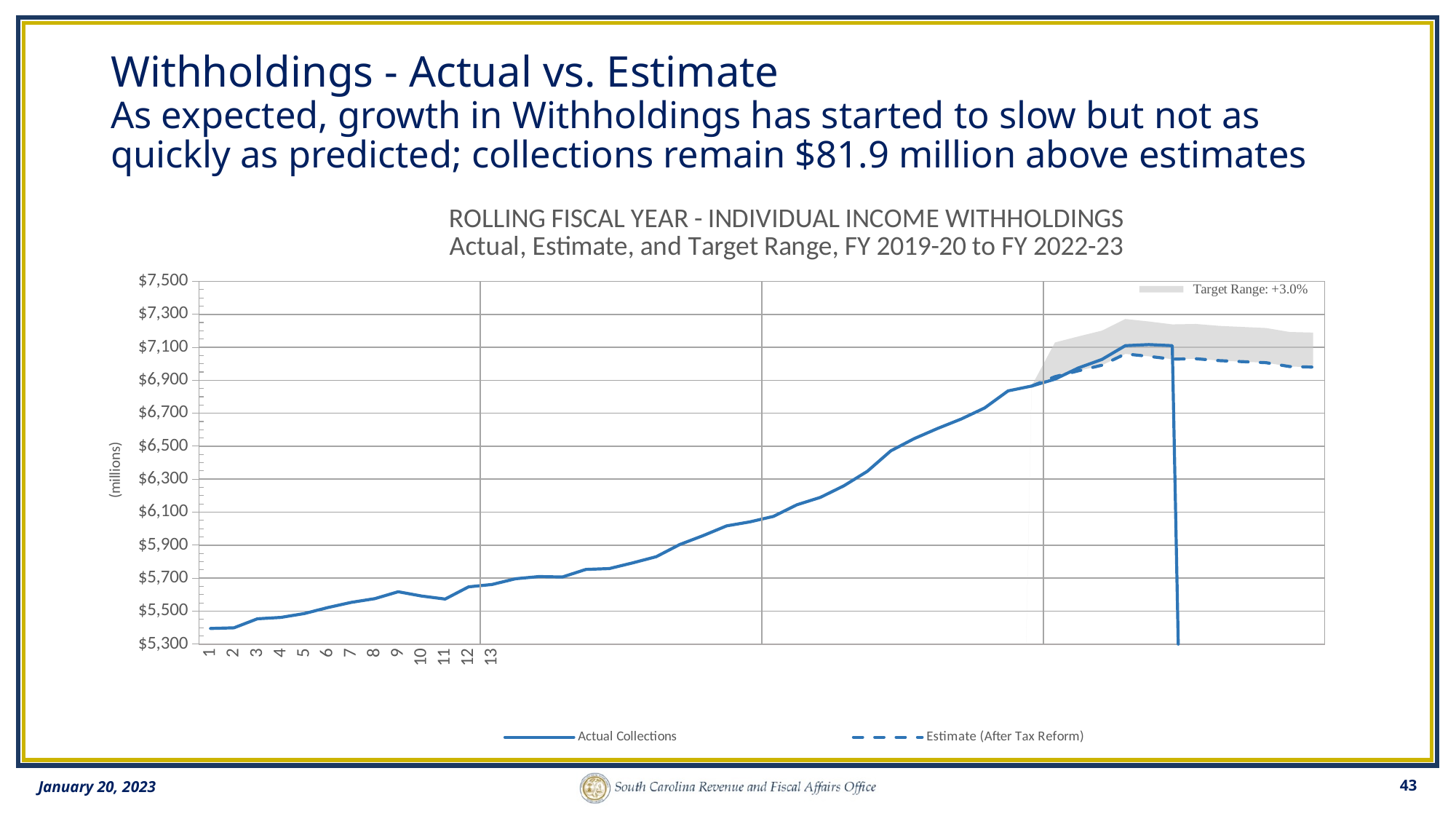
What kind of chart is shown on the slide? Line chart Which is larger, the Actual Collections value at point 9 or at point 11? Point 9 Is the Actual Collections value at point 1 greater or less than $5,500? less Which is larger, the Actual Collections value at point 1 or at point 13? Point 13 Do the Actual Collections values generally rise or fall along the x axis? Rise Is the Actual Collections value at point 13 greater or less than $5,700? less What is the lowest value shown on the y axis? $5,300 How many series does the legend at the bottom of the chart list? 2 Is the Actual Collections value at point 9 greater or less than $5,500? greater Which series is drawn with a dashed line? Estimate (After Tax Reform) What is the title of the chart? ROLLING FISCAL YEAR - INDIVIDUAL INCOME WITHHOLDINGS Actual, Estimate, and Target Range, FY 2019-20 to FY 2022-23